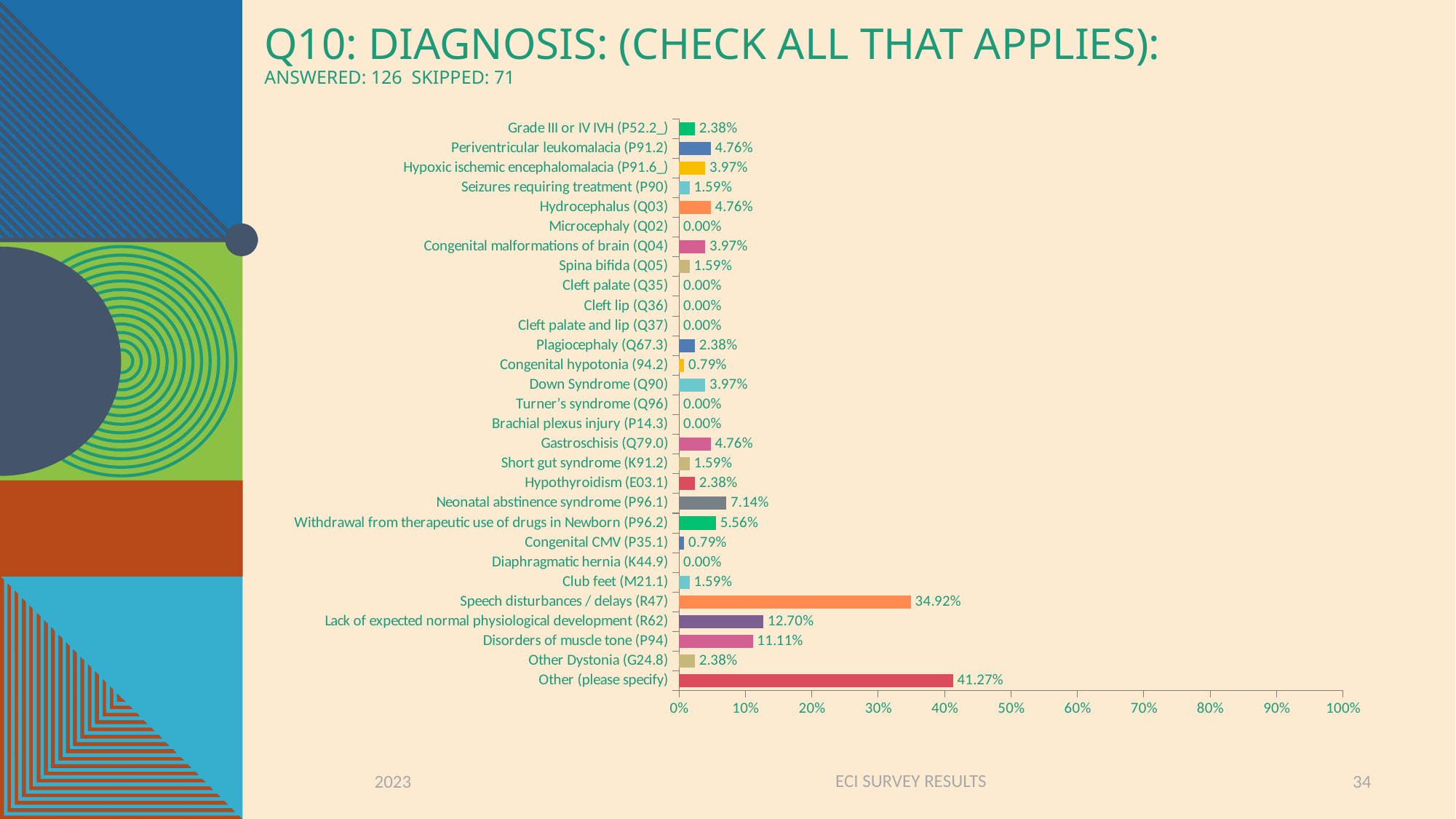
Is the value for Other (please specify) greater or less than 40%? greater What is the difference between Other (please specify) and Speech disturbances / delays (R47)? 6.35% What percentage is shown for Speech disturbances / delays (R47)? 34.92% What kind of chart is shown on the slide? Bar chart How many diagnosis categories are plotted on the chart? 29 Which category has the highest percentage? Other (please specify) Which is larger: Lack of expected normal physiological development (R62) or Disorders of muscle tone (P94)? Lack of expected normal physiological development (R62) What percentage is shown for Disorders of muscle tone (P94)? 11.11% How many respondents answered this question according to the slide? 126 How many categories show a value of 0.00%? 7 What is the value for Withdrawal from therapeutic use of drugs in Newborn (P96.2)? 5.56% What is the value for Neonatal abstinence syndrome (P96.1)? 7.14%